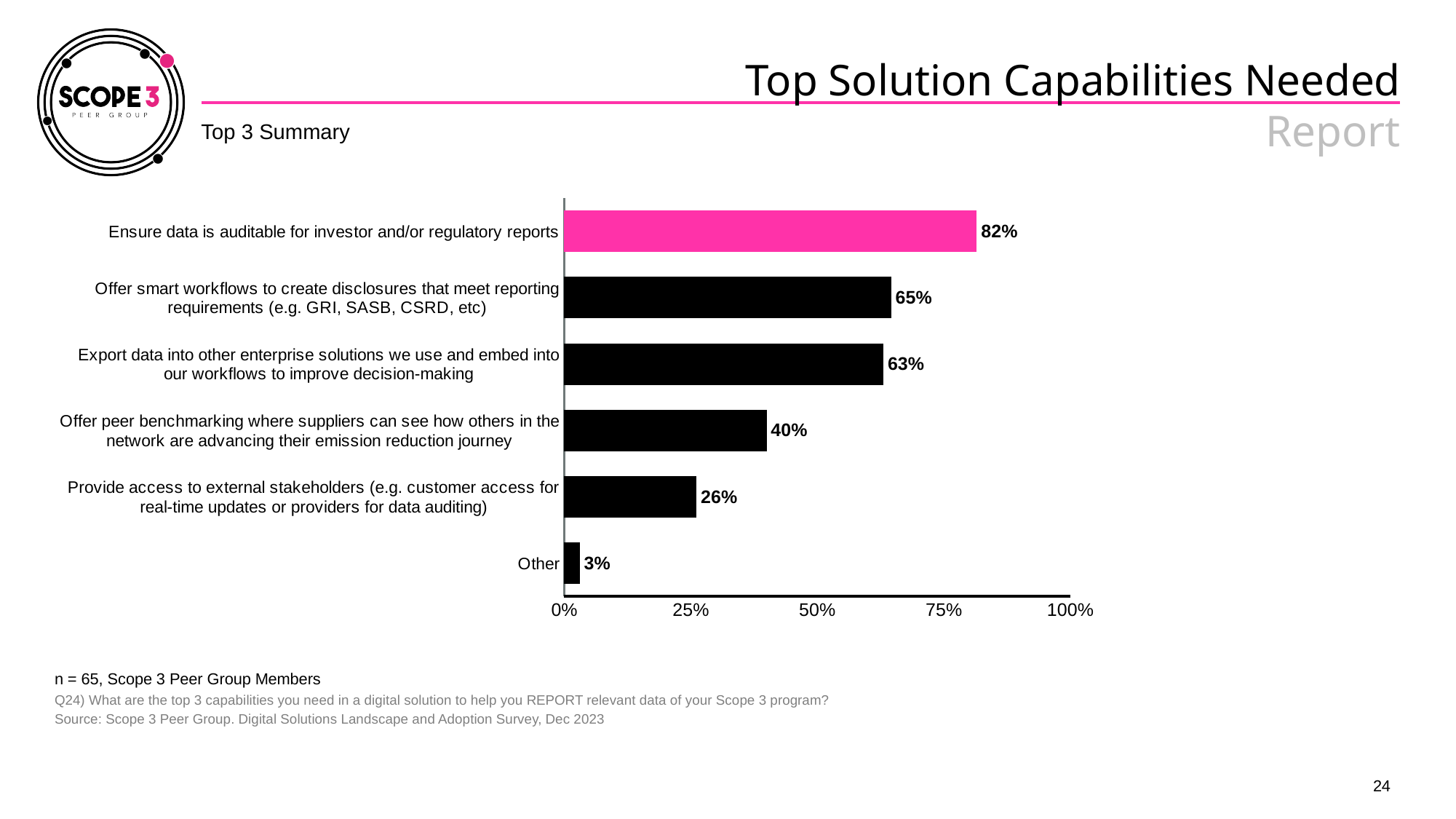
Is the value for 'Export data into other enterprise solutions we use and embed into our workflows to improve decision-making' greater or less than 50%? greater Which capability has the highest percentage? Ensure data is auditable for investor and/or regulatory reports Which is larger: the value for 'Offer peer benchmarking' or the value for 'Provide access to external stakeholders'? Offer peer benchmarking How many categories are shown in the chart? 6 Which category has the lowest percentage? Other What kind of chart is shown on the slide? Bar chart What is the difference between the values for 'Provide access to external stakeholders' and 'Other'? 23% What percentage of respondents selected 'Ensure data is auditable for investor and/or regulatory reports'? 82% Which bar is highlighted in pink rather than black? Ensure data is auditable for investor and/or regulatory reports What is the value for 'Offer peer benchmarking where suppliers can see how others in the network are advancing their emission reduction journey'? 40% What is the difference between the value for 'Ensure data is auditable for investor and/or regulatory reports' and the value for 'Offer smart workflows to create disclosures that meet reporting requirements'? 17% What is the value shown for 'Other'? 3%